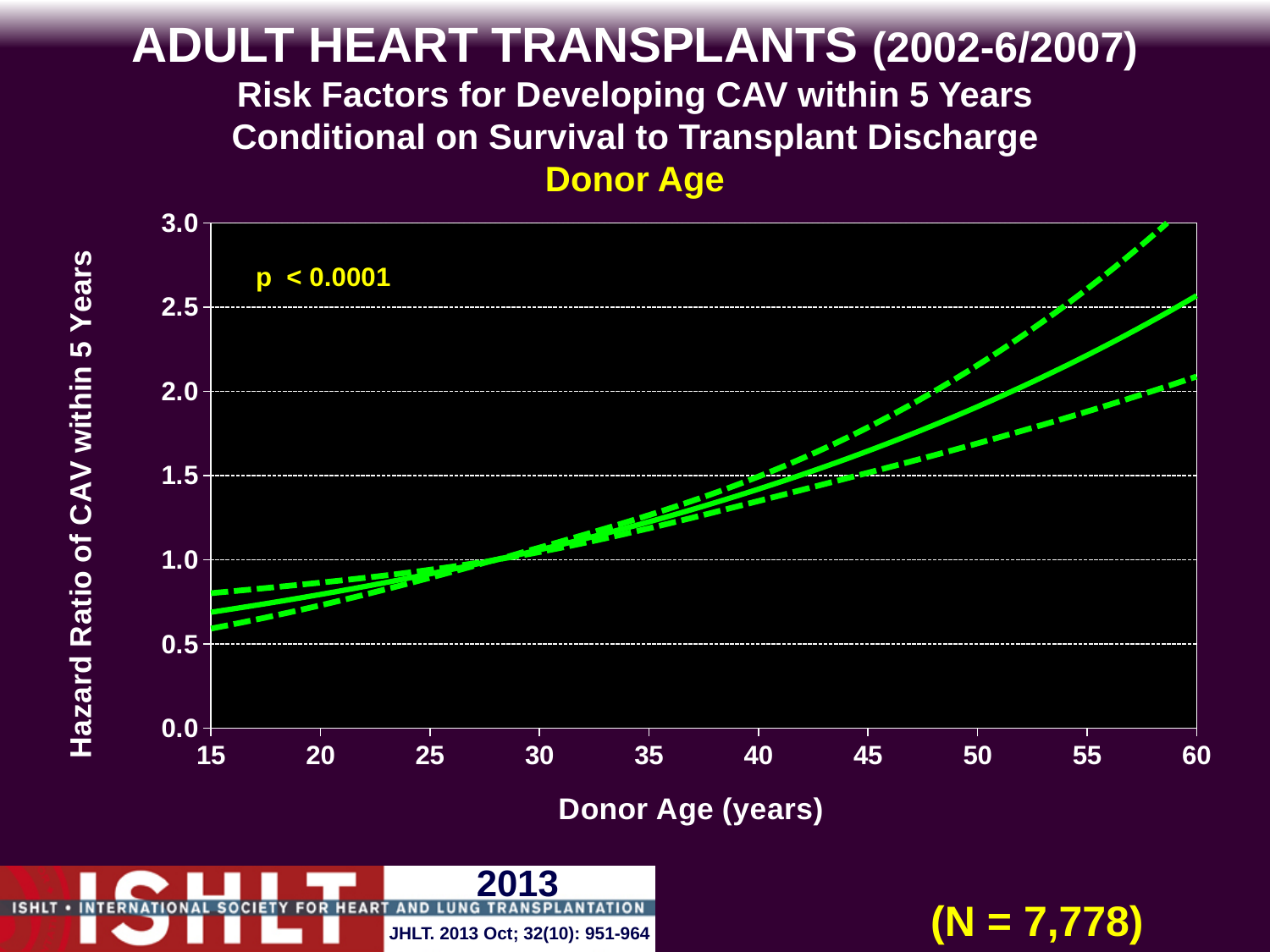
How many tick labels are shown on the donor age (x) axis? 10 Is the hazard ratio on the solid line at donor age 35 greater or less than 1.0? greater How many lines are plotted on the chart? 3 Is the hazard ratio on the solid line at donor age 15 greater or less than 1.0? less Is the hazard ratio on the solid line at donor age 60 greater or less than 2.0? greater What kind of chart is shown on the slide? line chart What p-value is printed on the chart? p < 0.0001 What is the highest value labelled on the y axis? 3.0 Does the hazard ratio of CAV within 5 years rise or fall as donor age increases from 15 to 60 years? rise